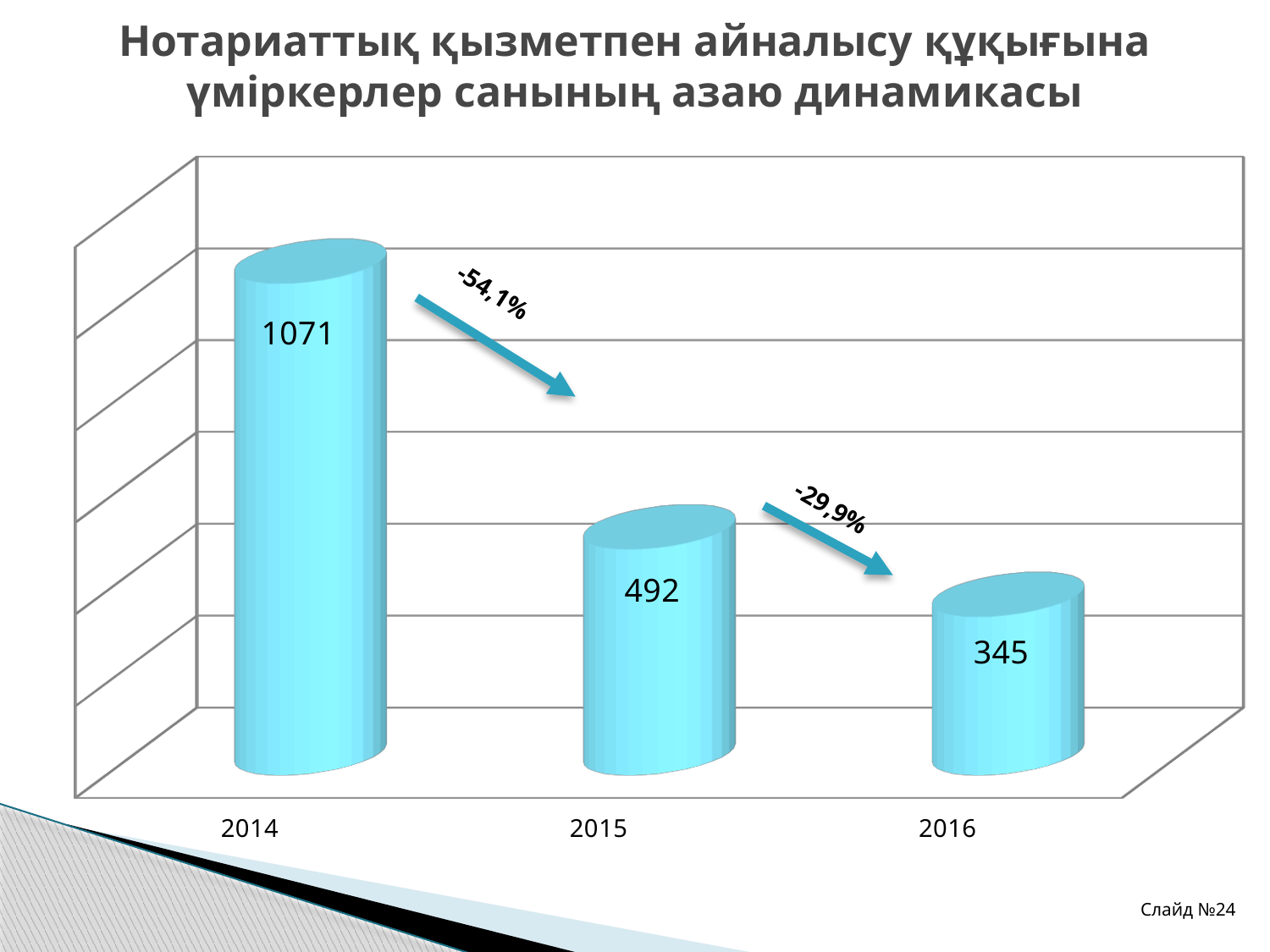
What is the difference between the values for 2014 and 2015? 579 Which is larger, the value for 2015 or the value for 2016? 2015 Which year has the highest value? 2014 What is the value for 2015? 492 What is the value for 2014? 1071 How many years are shown on the x axis? 3 Do the values rise or fall from 2014 to 2016? fall What is the difference between the values for 2015 and 2016? 147 What percentage change is labelled on the arrow between 2014 and 2015? -54,1% What kind of chart is this? bar chart What is the value for 2016? 345 Which year has the lowest value? 2016